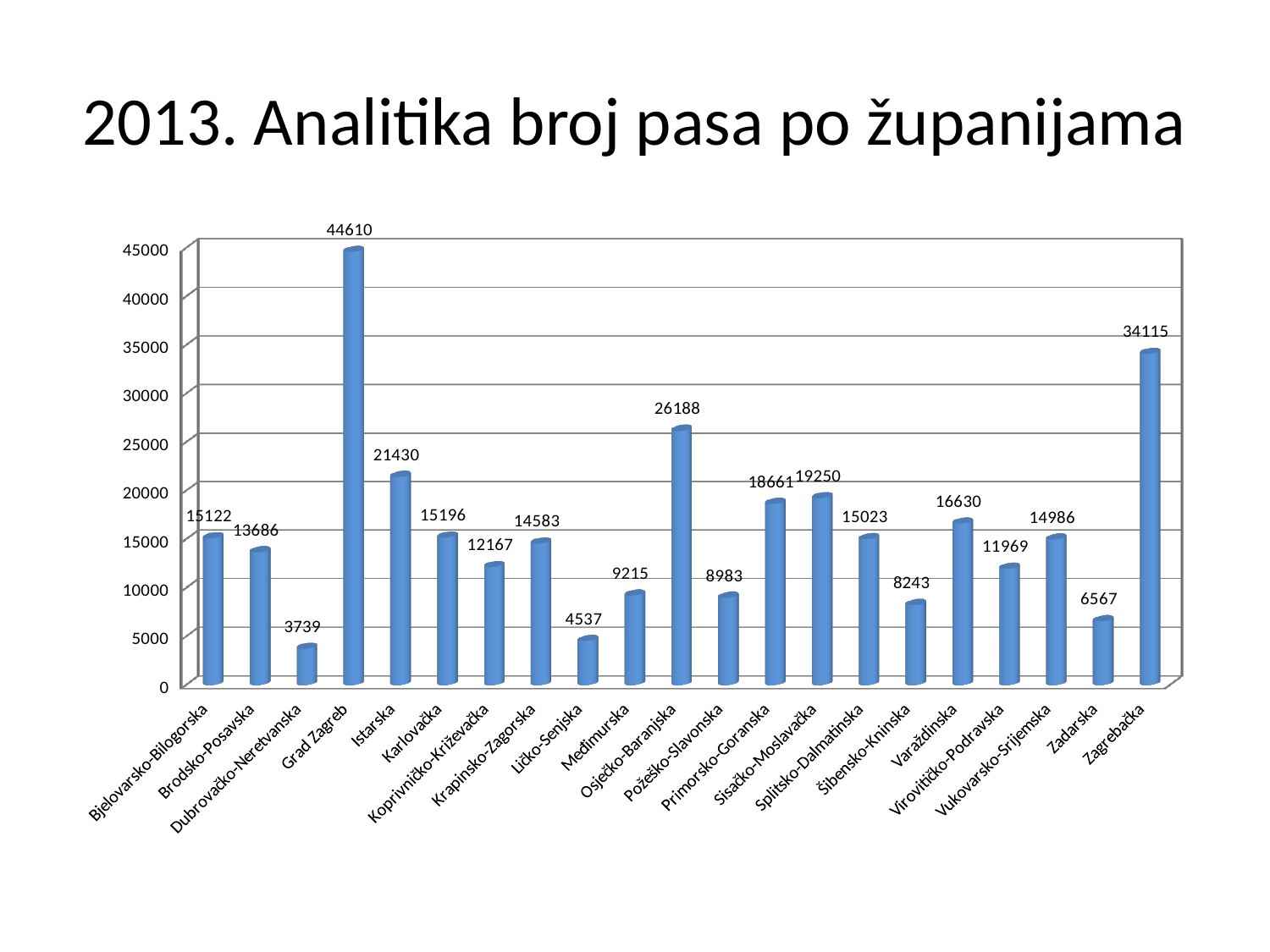
What is the value for Varaždinska? 16630 What is the difference between the values for Grad Zagreb and Zagrebačka? 10495 How many categories are shown on the x axis? 21 Which is larger, the value for Sisačko-Moslavačka or the value for Primorsko-Goranska? Sisačko-Moslavačka What kind of chart is shown on the slide? bar chart What is the title of the slide? 2013. Analitika broj pasa po županijama Which category has the highest value? Grad Zagreb Which category has the lowest value? Dubrovačko-Neretvanska What is the value for Osječko-Baranjska? 26188 What is the difference between the values for Istarska and Karlovačka? 6234 What is the value for Ličko-Senjska? 4537 What is the value for Grad Zagreb? 44610